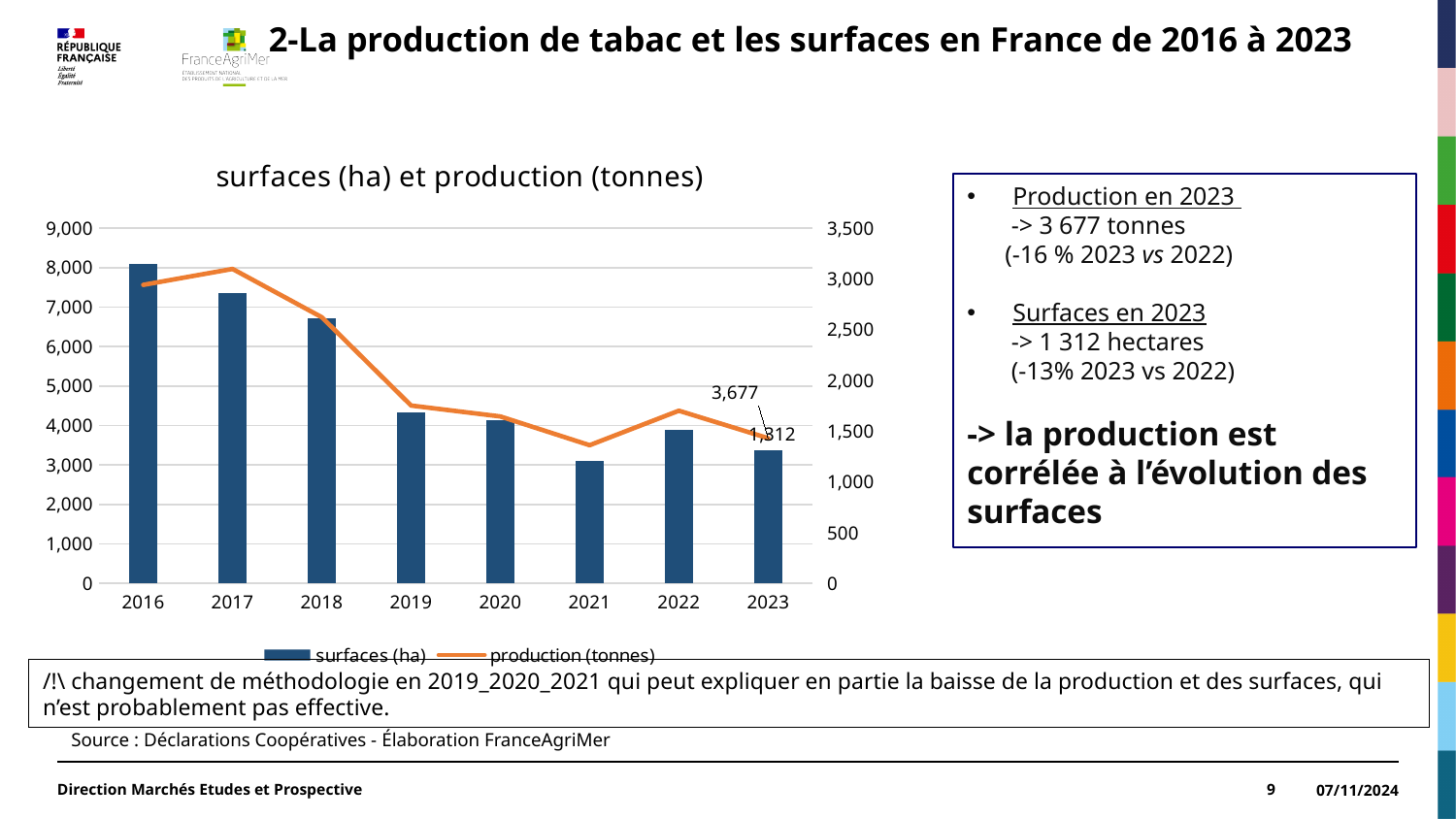
What kind of chart is shown on the slide? Combined bar and line chart How many series does the chart legend list? 2 What is the surfaces (ha) value labelled for 2023? 1,312 What is the production (tonnes) value labelled for 2023? 3,677 Is the production (tonnes) value for 2016 greater or less than 7,000 on the left axis? greater Is the production (tonnes) value for 2021 greater or less than 4,000 on the left axis? less In which year is the production (tonnes) line at its lowest point? 2021 Is the surfaces (ha) bar for 2022 taller or shorter than the bar for 2023? taller How many years are shown on the x axis of the chart? 8 Overall, do the surfaces (ha) bars rise or fall from 2016 to 2023? fall Which year has the lowest surfaces (ha) bar? 2021 Which year has the highest surfaces (ha) bar? 2016